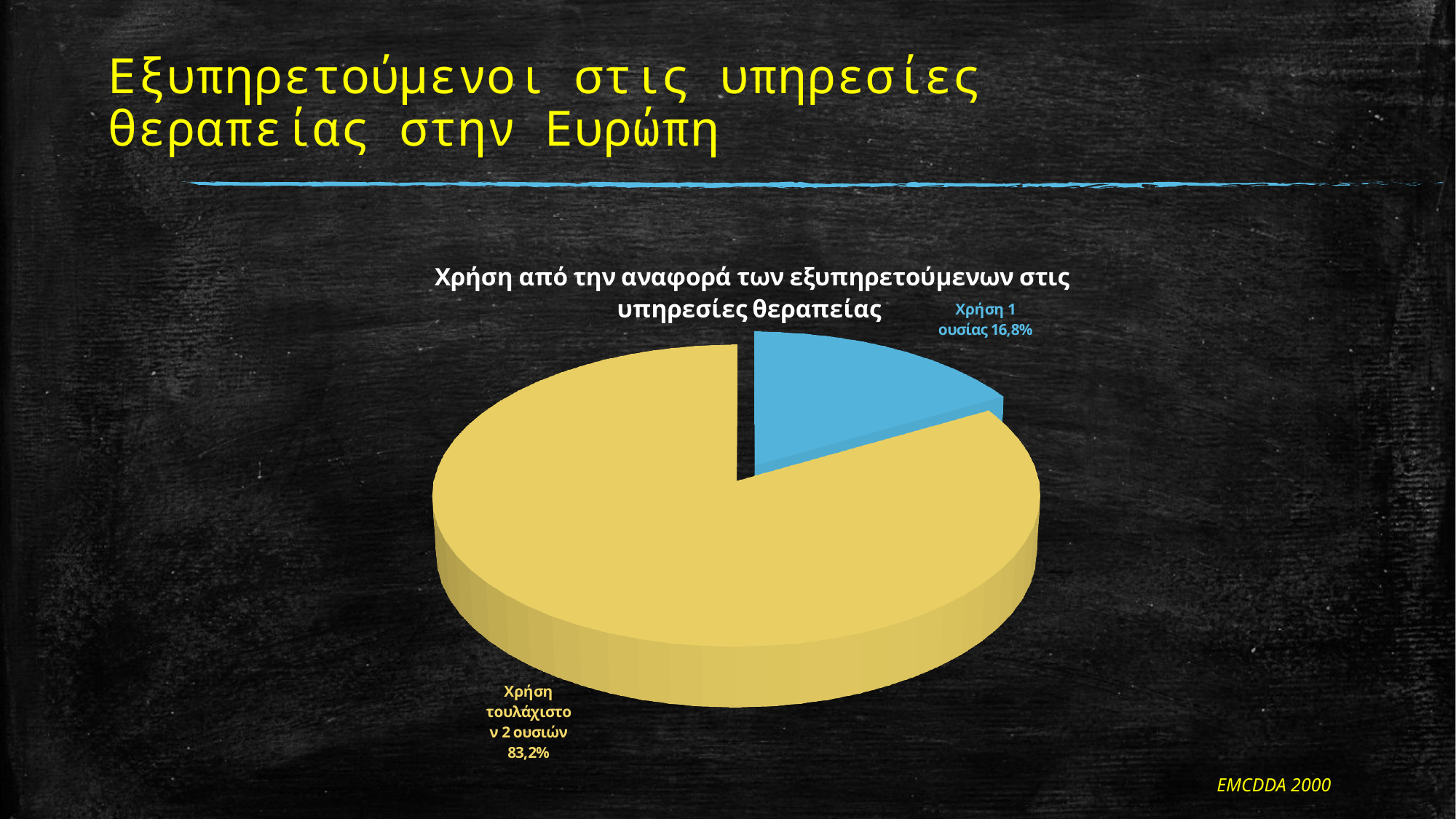
What is the total of the two slice percentages shown on the pie chart? 100% Which slice of the pie chart is the smallest? Χρήση 1 ουσίας What share of the pie does the "Χρήση 1 ουσίας" slice represent? 16,8% What percentage is shown for "Χρήση 1 ουσίας"? 16,8% What percentage is shown for "Χρήση τουλάχιστον 2 ουσιών"? 83,2% What is the title of the chart? Χρήση από την αναφορά των εξυπηρετούμενων στις υπηρεσίες θεραπείας What is the difference in percentage points between "Χρήση τουλάχιστον 2 ουσιών" and "Χρήση 1 ουσίας"? 66,4 What type of chart is shown on the slide? Pie chart Which slice of the pie chart is the largest? Χρήση τουλάχιστον 2 ουσιών Which is larger: the share for "Χρήση 1 ουσίας" or the share for "Χρήση τουλάχιστον 2 ουσιών"? Χρήση τουλάχιστον 2 ουσιών What colour is the "Χρήση 1 ουσίας" slice? Blue How many slices does the pie chart have? 2